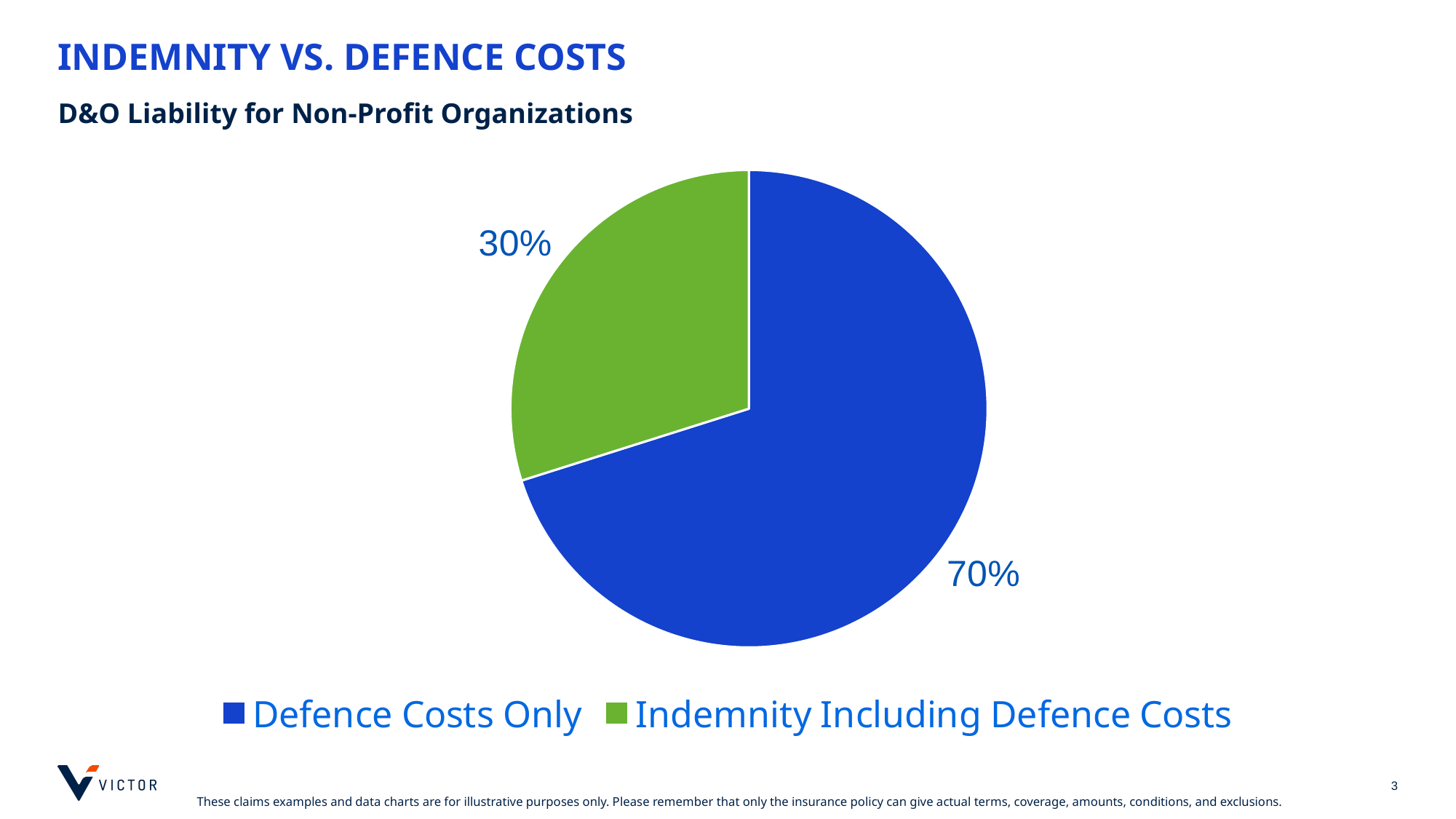
Which slice of the pie is the largest? Defence Costs Only Which is larger: Defence Costs Only or Indemnity Including Defence Costs? Defence Costs Only What share of the pie does the Indemnity Including Defence Costs slice represent? 30% What is the difference in percentage points between Defence Costs Only and Indemnity Including Defence Costs? 40 What percentage of the pie is Indemnity Including Defence Costs? 30% What kind of chart is shown on the slide? pie chart How many slices does the pie chart have? 2 What percentage of the pie is Defence Costs Only? 70% Which slice of the pie is the smallest? Indemnity Including Defence Costs What is the title of the slide containing the chart? INDEMNITY VS. DEFENCE COSTS What colour is the Defence Costs Only slice? blue How many entries does the legend list? 2